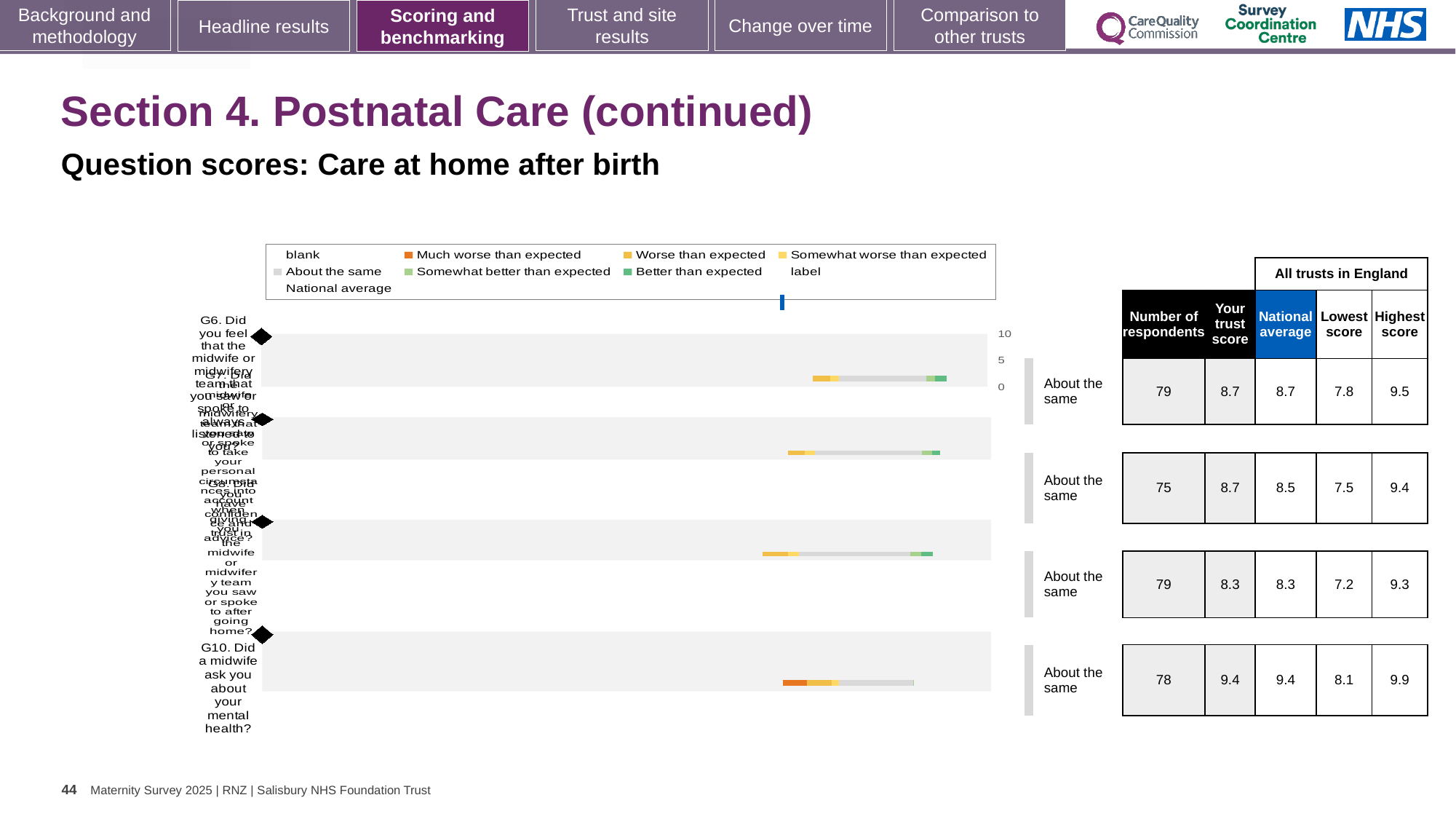
What is the national average for the top bar, G6? 8.7 Which question has the highest trust score? G10 What benchmark category is shown for G10? About the same How many respondents are listed for G10 (Did a midwife ask you about your mental health?)? 78 In the chart legend, what colour represents 'Much worse than expected'? orange What is the highest score across all trusts in England for G10? 9.9 In the chart legend, what colour represents 'Better than expected'? green What is the difference between the highest score and the lowest score for G10? 1.8 Which has the larger trust score, G6 or G10? G10 How many question bars are plotted in the chart? 4 What is the trust score for G10 (Did a midwife ask you about your mental health?)? 9.4 What kind of chart is shown on the slide? bar chart